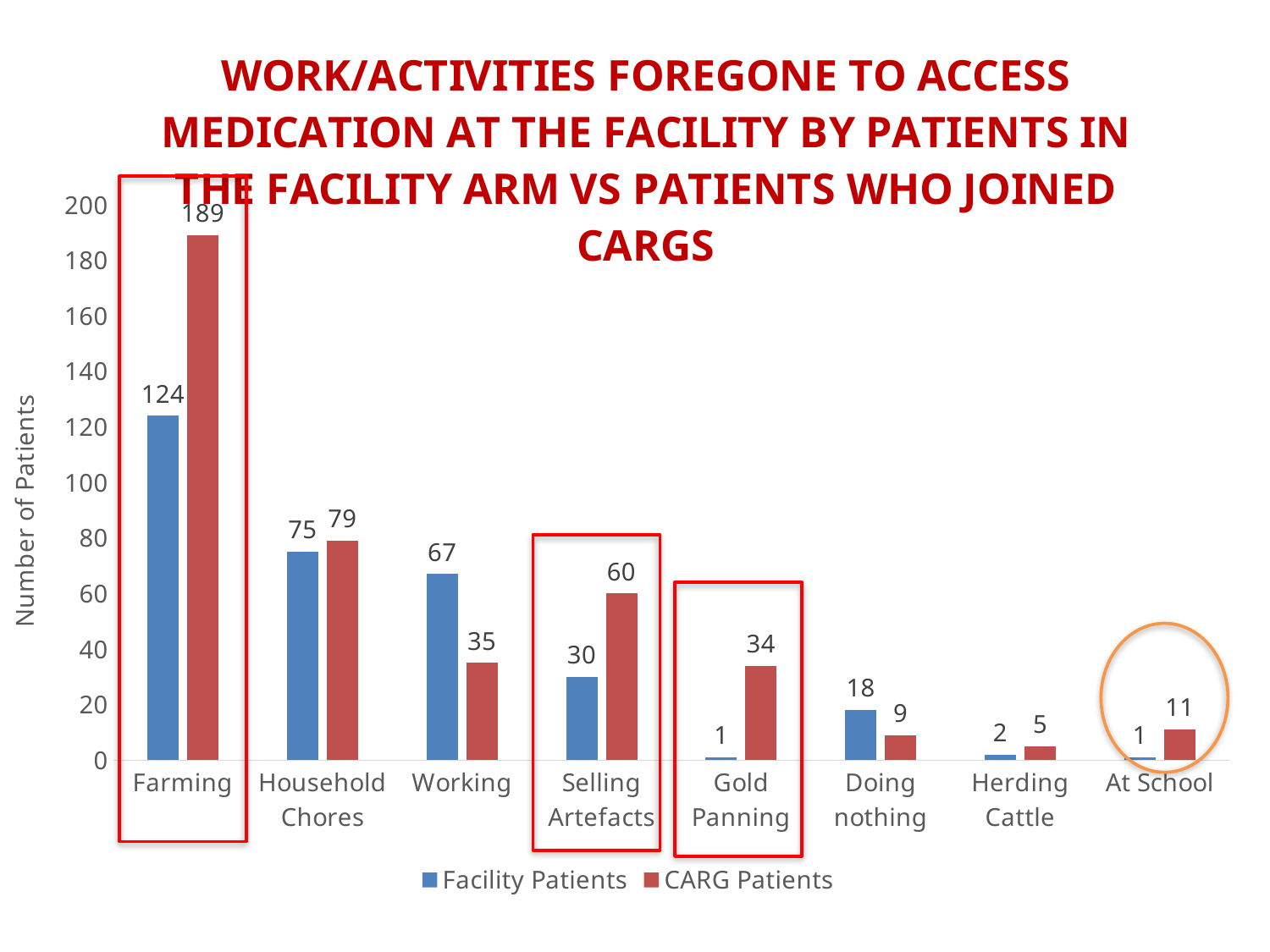
What is the label of the y axis? Number of Patients How many Facility Patients forwent Farming to access medication? 124 Which category has the highest value for CARG Patients? Farming Which category has the lowest value for CARG Patients? Herding Cattle How many series does the legend list? 2 Which is larger for Working: Facility Patients or CARG Patients? Facility Patients What is the difference between CARG Patients and Facility Patients for Farming? 65 What is the value for Facility Patients in the Gold Panning category? 1 What is the value for CARG Patients in the Selling Artefacts category? 60 Is the value for CARG Patients in Household Chores greater or less than 60? greater What kind of chart is shown on the slide? Bar chart How many activity categories are shown on the x axis? 8